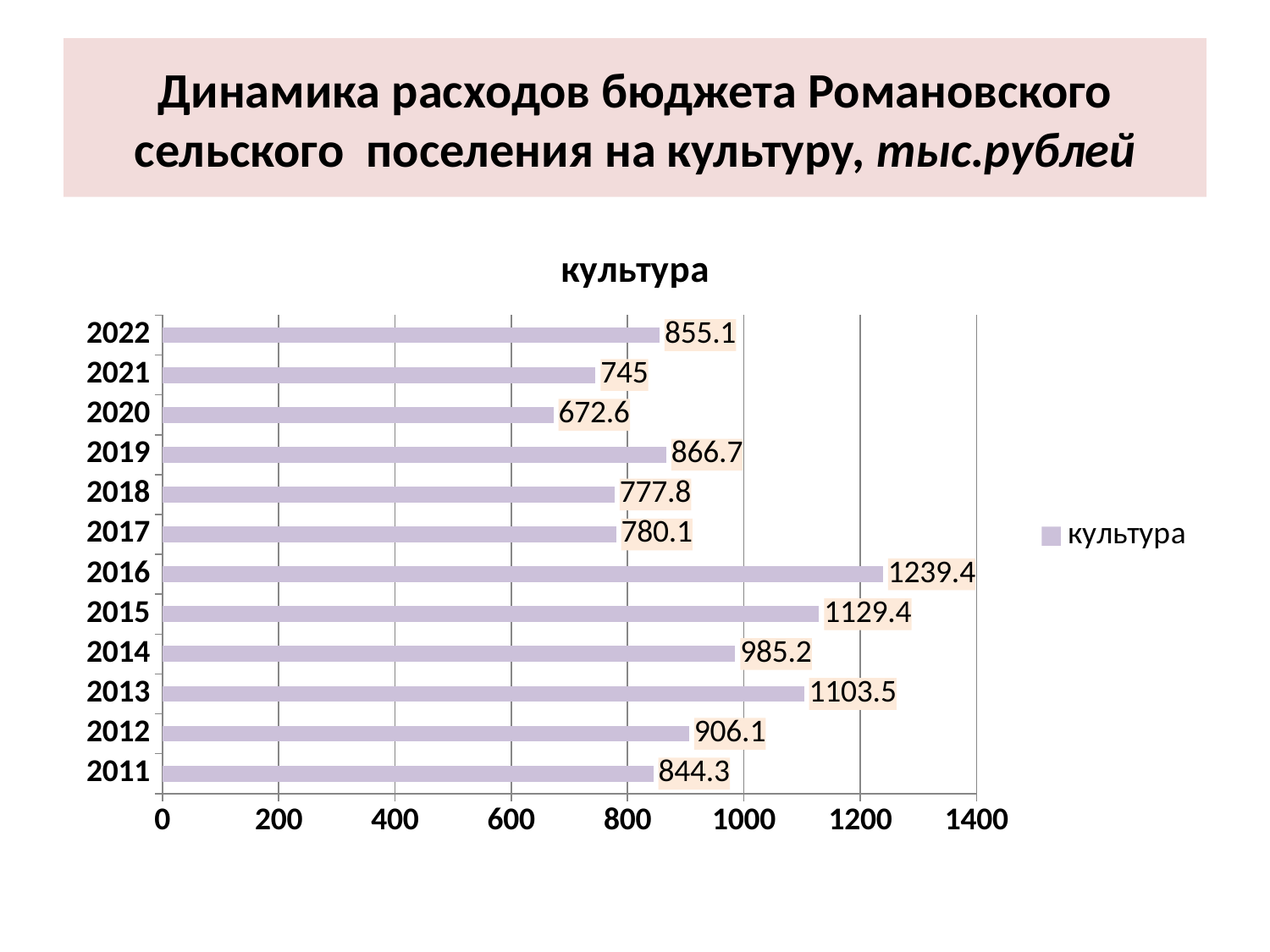
How many years are shown on the chart? 12 What is the value for 2016? 1239.4 Is the value for 2019 greater or less than 800? greater What is the difference between the values for 2016 and 2015? 110 Which year has the highest value? 2016 What is the difference between the values for 2022 and 2021? 110.1 What kind of chart is shown on the slide? bar chart Which is larger, the value for 2013 or the value for 2014? 2013 What is the value for 2021? 745 What is the title of the chart? культура How many series does the legend list? 1 Which year has the lowest value? 2020